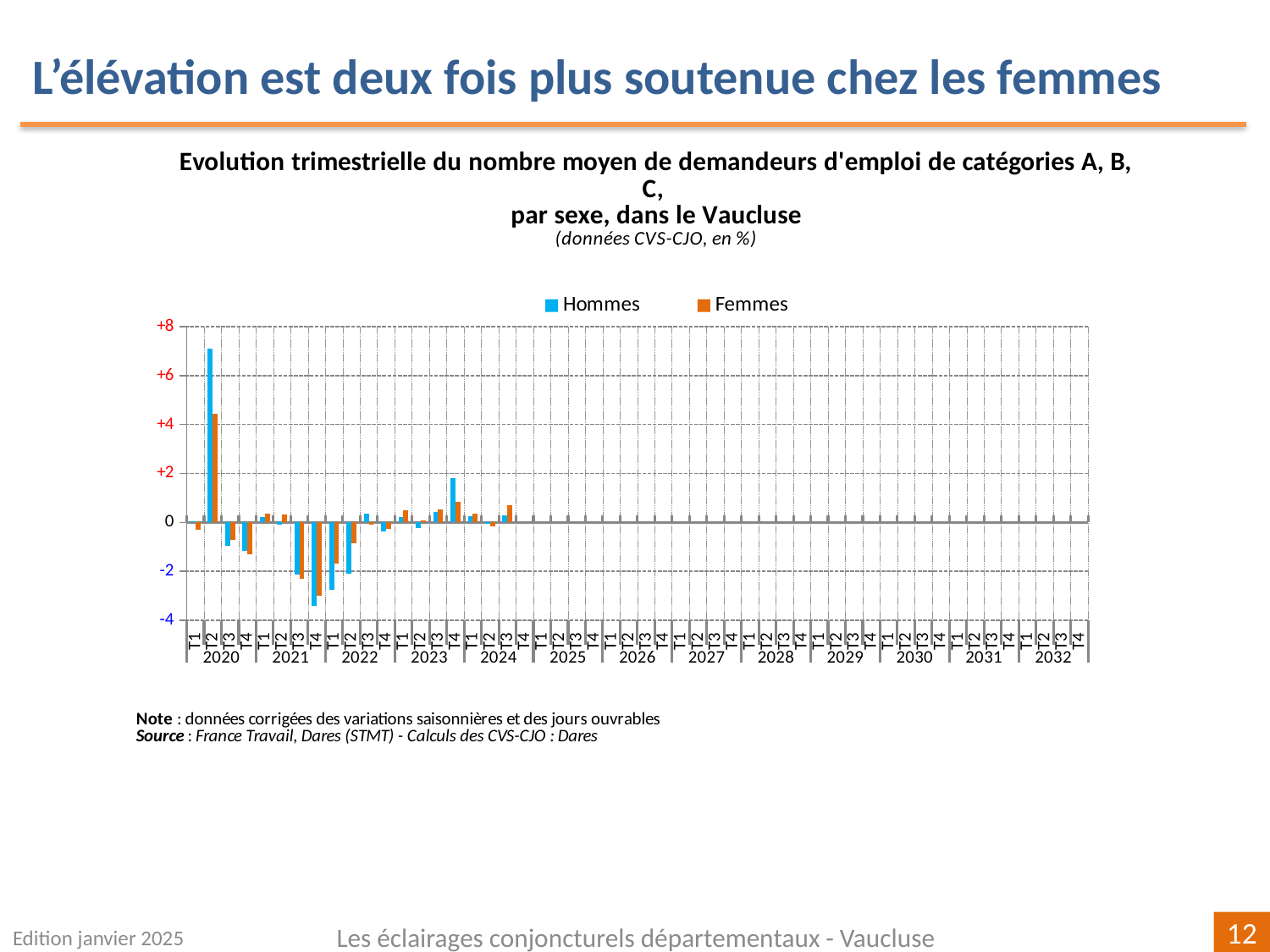
Is the value for Hommes in T4 2021 greater or less than -2? less How many years are labelled along the x axis? 13 What kind of chart is shown on the slide? bar chart In T2 2020, which series has the larger value, Hommes or Femmes? Hommes How many series does the legend list? 2 Is the value for Femmes in T2 2020 greater or less than +2? greater Is the value for Hommes in T2 2020 greater or less than +6? greater In which quarter does the Hommes series reach its highest value? T2 2020 What are the two series named in the legend? Hommes and Femmes In which quarter does the Hommes series reach its lowest value? T4 2021 In T4 2021, which series has the lower value, Hommes or Femmes? Hommes Which colour represents the Femmes series? orange